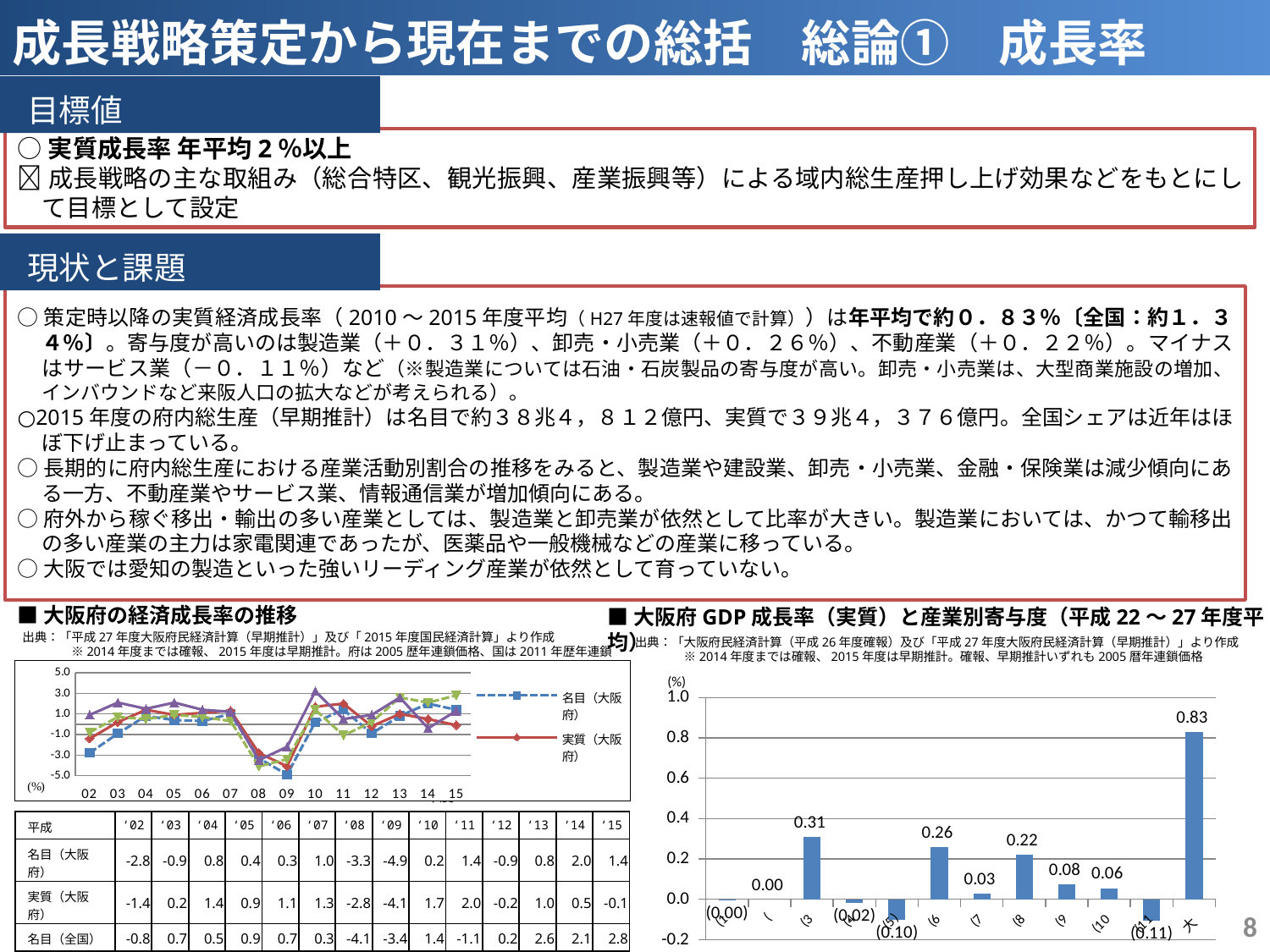
On the left chart (大阪府の経済成長率の推移), how many years are plotted along the x axis? 14 On the left chart (大阪府の経済成長率の推移), in which year is 名目（大阪府） lowest? '09 On the right chart (大阪府GDP成長率（実質）と産業別寄与度), how many bars are plotted? 12 On the right chart (大阪府GDP成長率（実質）と産業別寄与度), what is the value of the tallest bar? 0.83 On the left chart (大阪府の経済成長率の推移), what is the difference between 名目（大阪府） and 実質（大阪府） in '14? 1.5 On the left chart (大阪府の経済成長率の推移), in which year is 実質（大阪府） highest? '11 On the left chart (大阪府の経済成長率の推移), what is the 名目（全国） value for '13? 2.6 On the left chart (大阪府の経済成長率の推移), what is the 実質（大阪府） value for '11? 2.0 On the left chart (大阪府の経済成長率の推移), what kind of chart is it? line chart On the right chart (大阪府GDP成長率（実質）と産業別寄与度), what is the value of the lowest bar? (0.11) On the left chart (大阪府の経済成長率の推移), what is the 名目（大阪府） value for '09? -4.9 On the left chart (大阪府の経済成長率の推移), which is larger in '15: 名目（全国） or 名目（大阪府）? 名目（全国）